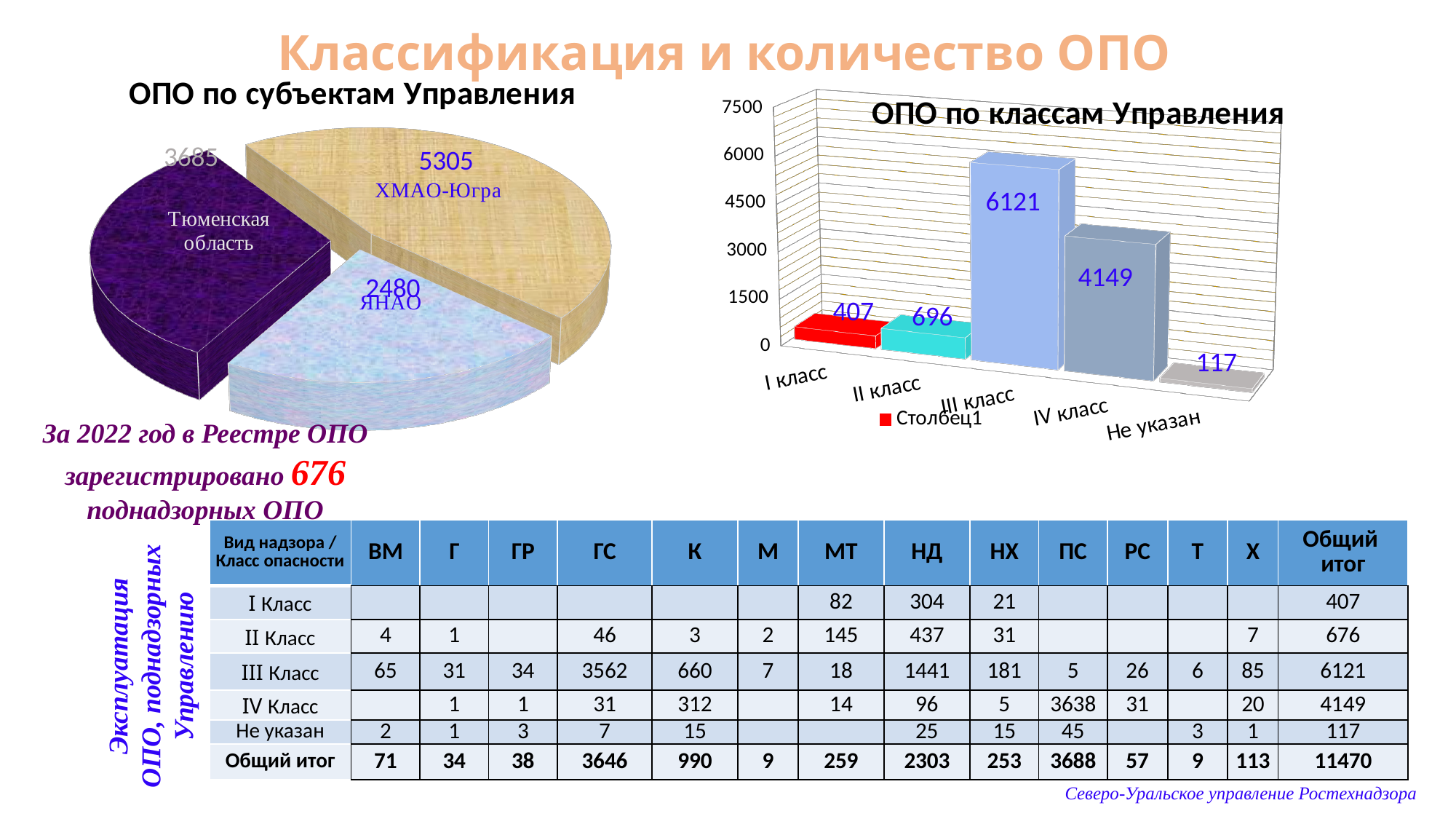
In the chart 'ОПО по субъектам Управления', what is the value for Тюменская область? 3685 In the chart 'ОПО по классам Управления', which is larger: I класс or II класс? II класс In the chart 'ОПО по классам Управления', what is the value for III класс? 6121 In the chart 'ОПО по классам Управления', what is the value for Не указан? 117 In the chart 'ОПО по классам Управления', what is the difference between III класс and IV класс? 1972 In the chart 'ОПО по классам Управления', which category has the highest value? III класс In the chart 'ОПО по субъектам Управления', what is the difference between the values for ХМАО-Югра and ЯНАО? 2825 What is the legend entry shown under the chart 'ОПО по классам Управления'? Столбец1 What kind of chart is 'ОПО по субъектам Управления'? Pie chart In the chart 'ОПО по субъектам Управления', which region has the smallest slice? ЯНАО In the chart 'ОПО по субъектам Управления', what is the value for ХМАО-Югра? 5305 How many categories are shown in the chart 'ОПО по классам Управления'? 5